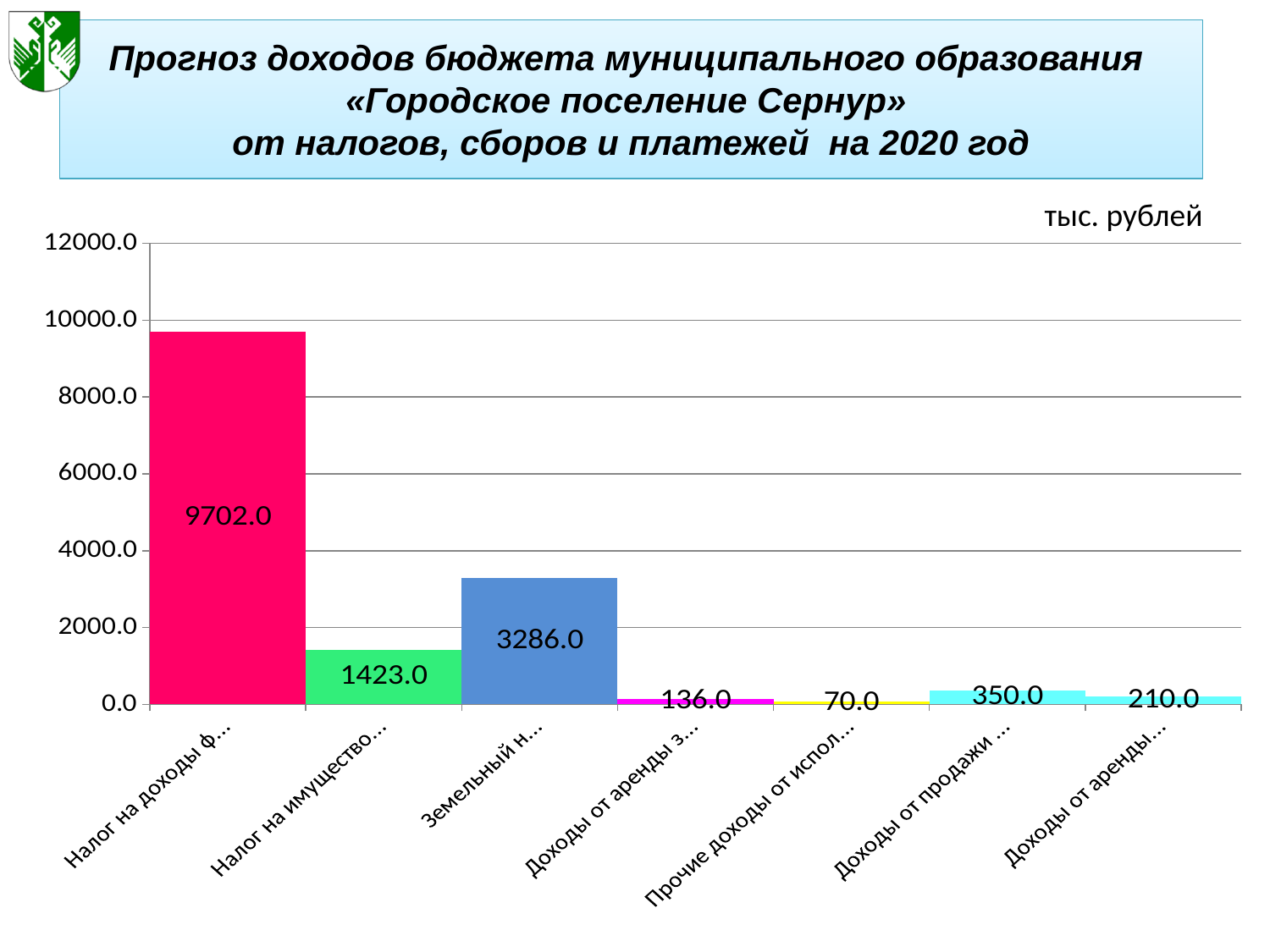
What is the value of the bar labelled "Земельный н…"? 3286.0 What type of chart is shown on the slide? bar chart What is the value of the bar labelled "Прочие доходы от испол…"? 70.0 How many bars (categories) are plotted in the chart? 7 What is the difference between the values for "Налог на доходы ф…" and "Земельный н…"? 6416.0 What is the value of the first bar, labelled "Налог на доходы ф…"? 9702.0 What is the value of the bar labelled "Доходы от продажи …"? 350.0 What unit is stated above the chart for the values? тыс. рублей Which is larger: the value for "Доходы от продажи …" or the value of the last bar, "Доходы от аренды…"? Доходы от продажи … Which category has the lowest value in the chart? Прочие доходы от испол… Which category has the highest value in the chart? Налог на доходы ф… What is the value of the bar labelled "Налог на имущество…"? 1423.0